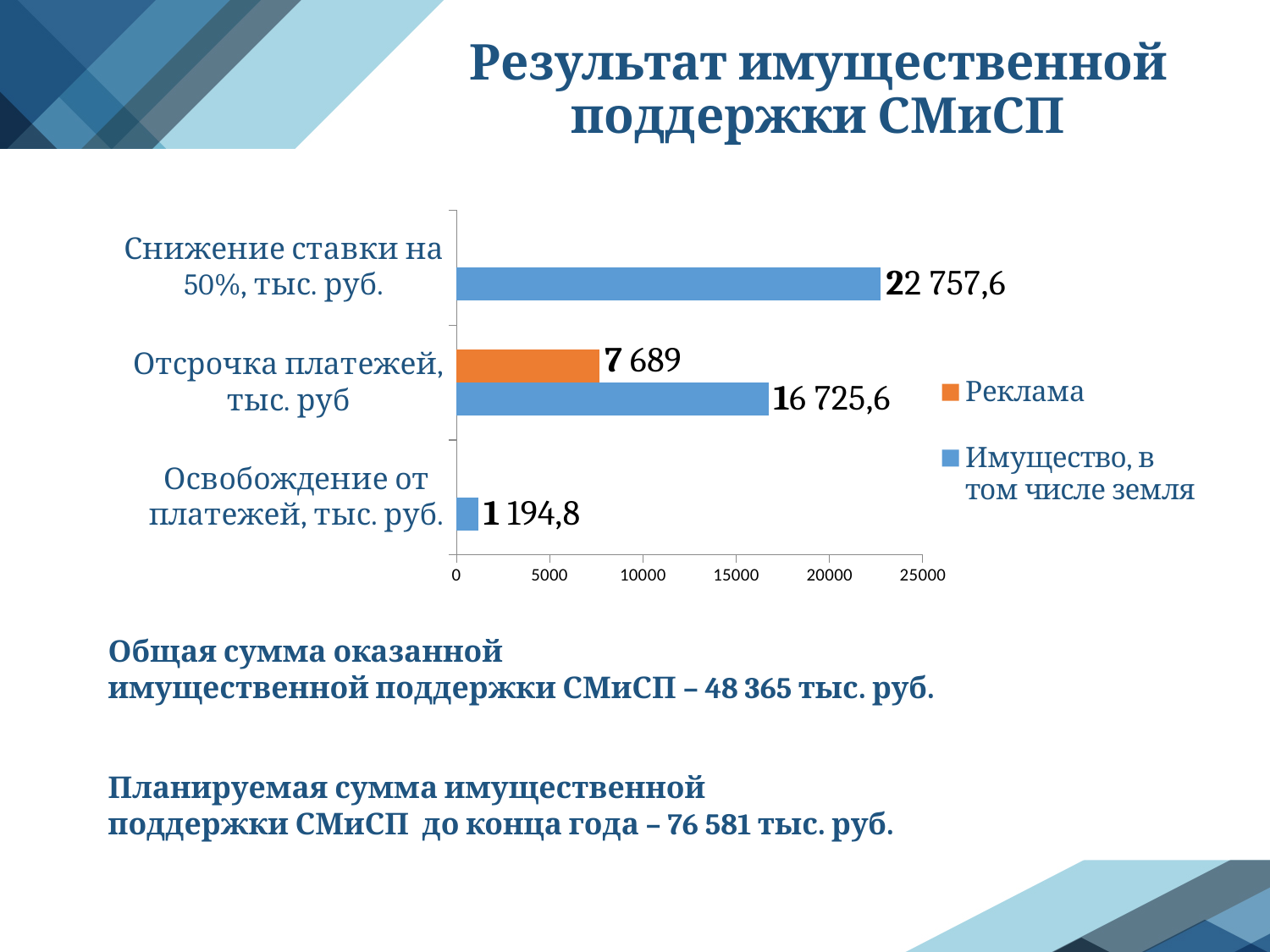
For "Отсрочка платежей, тыс. руб", which series has the larger value: "Реклама" or "Имущество, в том числе земля"? Имущество, в том числе земля What is the value of "Имущество, в том числе земля" for "Отсрочка платежей, тыс. руб"? 16 725,6 Which category has the highest value for "Имущество, в том числе земля"? Снижение ставки на 50%, тыс. руб. What colour are the "Реклама" bars in the chart? orange What is the difference between the "Имущество, в том числе земля" and "Реклама" values for "Отсрочка платежей, тыс. руб"? 9 036,6 How many categories are shown on the chart? 3 What is the value of "Реклама" for "Отсрочка платежей, тыс. руб"? 7 689 What is the value of "Имущество, в том числе земля" for "Освобождение от платежей, тыс. руб."? 1 194,8 What is the value of "Имущество, в том числе земля" for "Снижение ставки на 50%, тыс. руб."? 22 757,6 How many series does the legend list? 2 Which category has the lowest value for "Имущество, в том числе земля"? Освобождение от платежей, тыс. руб. What type of chart is shown on the slide? bar chart